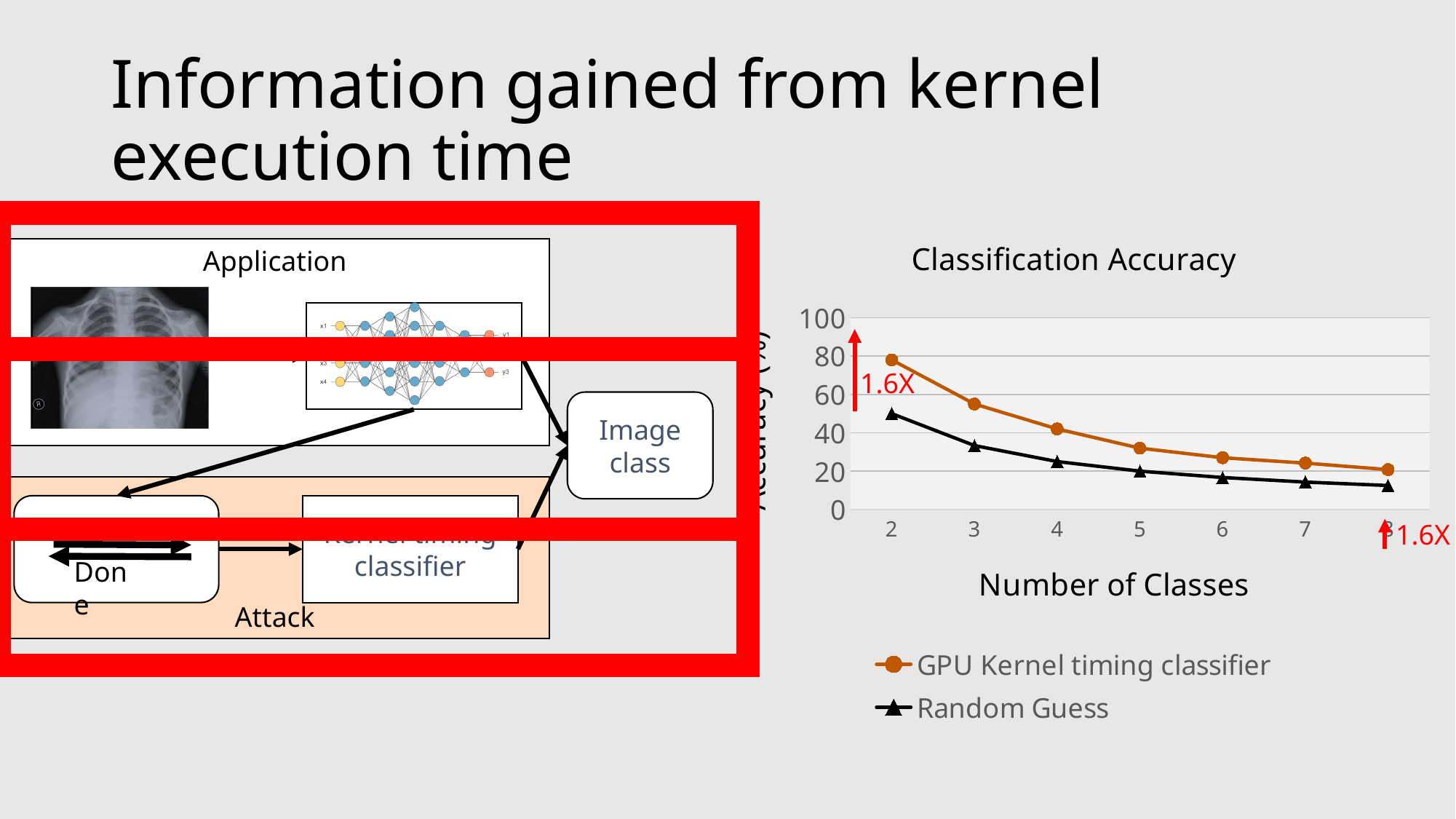
In the Classification Accuracy chart, does the accuracy of the GPU Kernel timing classifier rise or fall as the number of classes increases? fall At which number of classes is the GPU Kernel timing classifier accuracy highest? 2 Is the Random Guess accuracy at 8 classes greater or less than 20? less What kind of chart is shown on the slide? line chart How many series does the legend of the Classification Accuracy chart list? 2 Is the GPU Kernel timing classifier accuracy at 2 classes greater or less than 60? greater Is the GPU Kernel timing classifier accuracy at 5 classes greater or less than 20? greater How many data points does the GPU Kernel timing classifier series have in the Classification Accuracy chart? 7 What is the title of the chart on the slide? Classification Accuracy At which number of classes is the Random Guess accuracy lowest? 8 At 3 classes, which series has the higher accuracy: GPU Kernel timing classifier or Random Guess? GPU Kernel timing classifier What is the x-axis label of the Classification Accuracy chart? Number of Classes